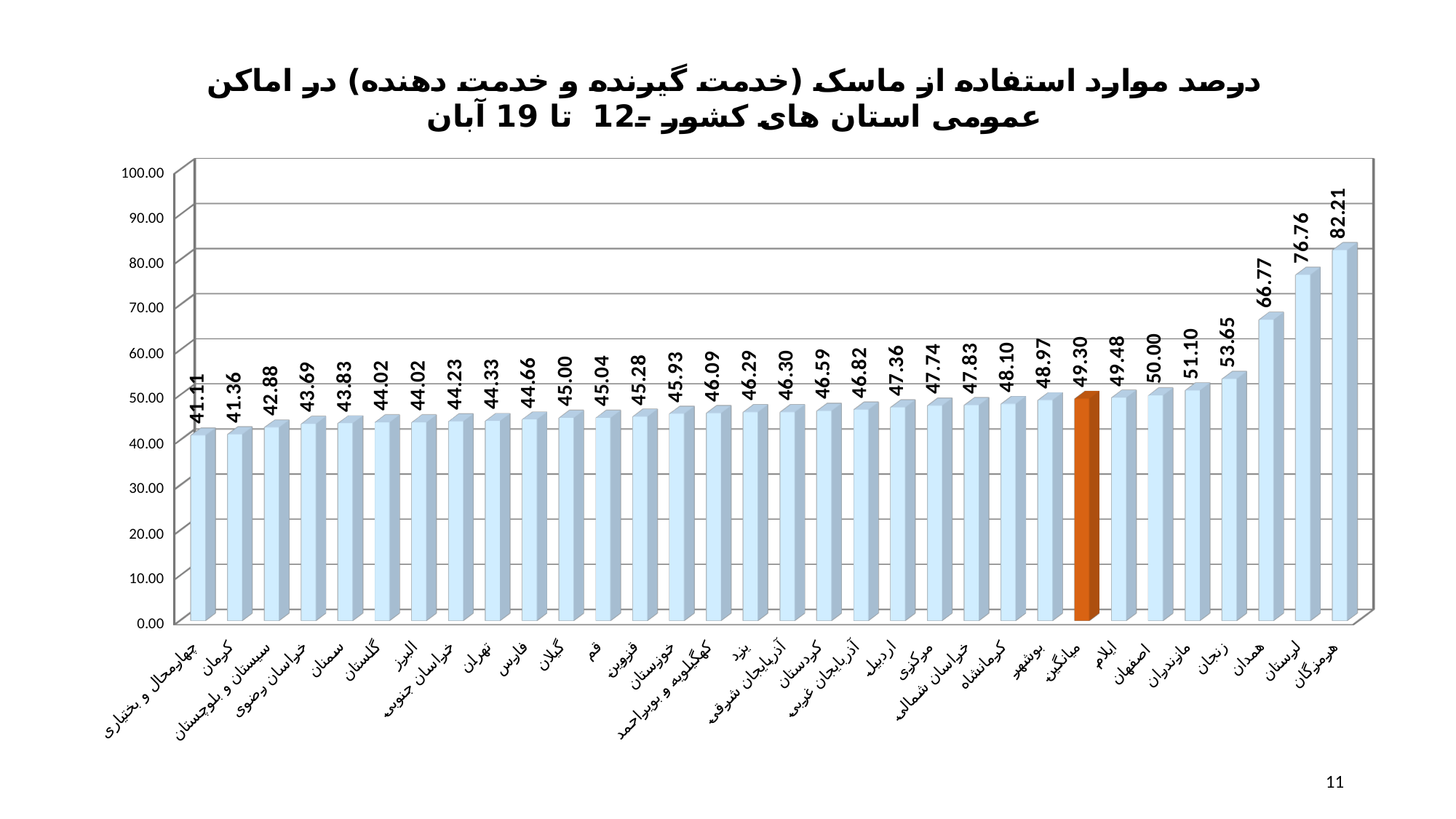
What kind of chart is shown on the slide? bar chart Is the value for همدان greater or less than 60.00? greater Which is larger, the value for اصفهان or the value for ایلام? اصفهان Which province has the lowest value? چهارمحال و بختیاری What is the value shown for the orange bar labelled میانگین? 49.30 What is the difference between the values for همدان and زنجان? 13.12 Which bar is coloured orange instead of light blue? میانگین Which province has the highest value? هرمزگان What is the value for هرمزگان? 82.21 What is the difference between the values for هرمزگان and لرستان? 5.45 How many bars are plotted in the chart? 32 What is the value for تهران? 44.33